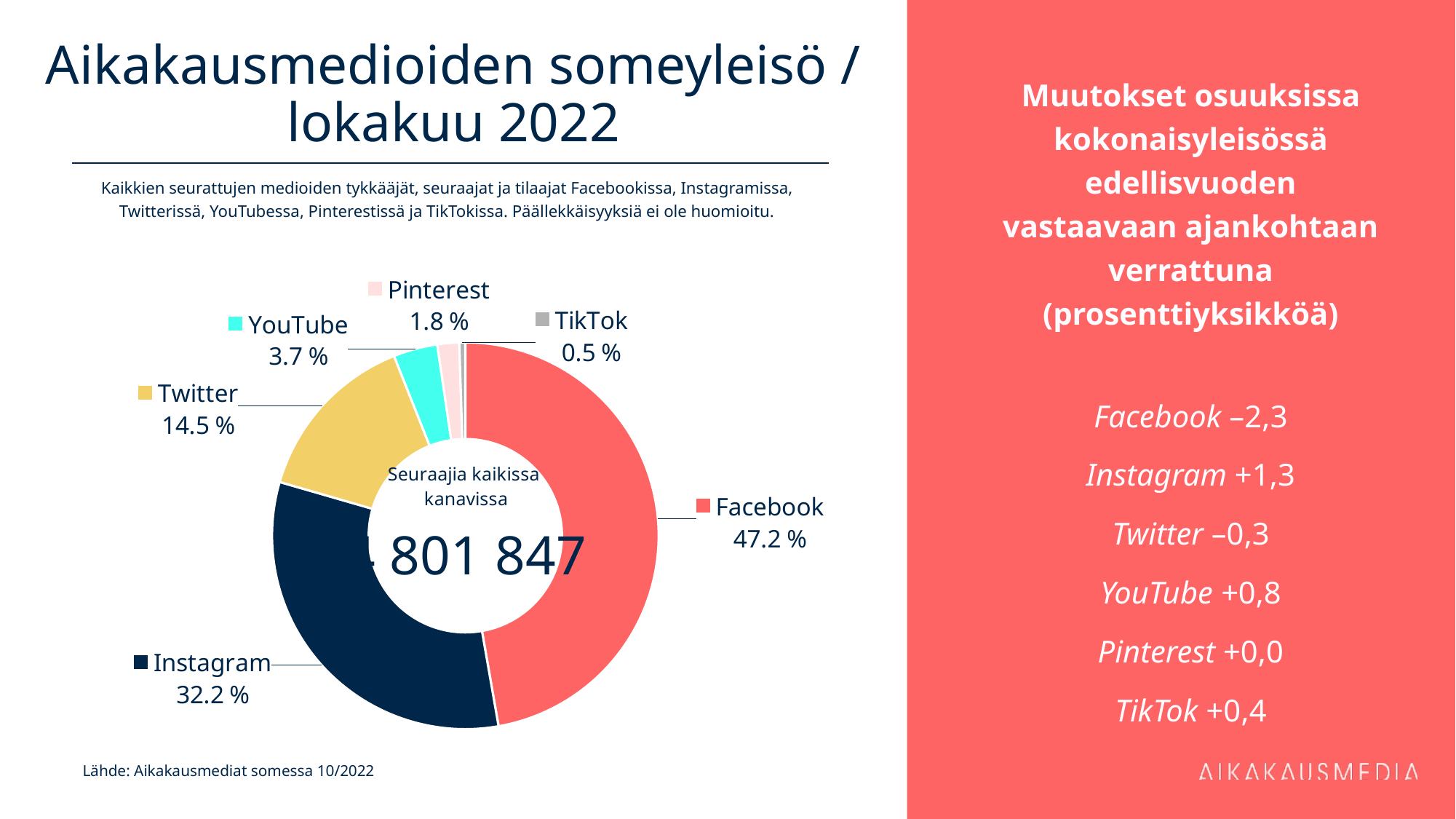
How many channels are shown in the chart? 6 Which has a larger share, YouTube or Pinterest? YouTube What share of the social media audience does Instagram hold? 32.2 % Which channel has the largest share of the audience? Facebook Which channel has the smallest share of the audience? TikTok What is the combined share of Twitter and YouTube? 18.2 % What colour is the Instagram segment in the chart? Dark navy blue How many percentage points larger is Facebook's share than Instagram's share? 15.0 % What share of the social media audience does Facebook hold? 47.2 % What type of chart is used on the slide? Donut (pie) chart What share of the social media audience does Twitter hold? 14.5 % What share of the social media audience does TikTok hold? 0.5 %